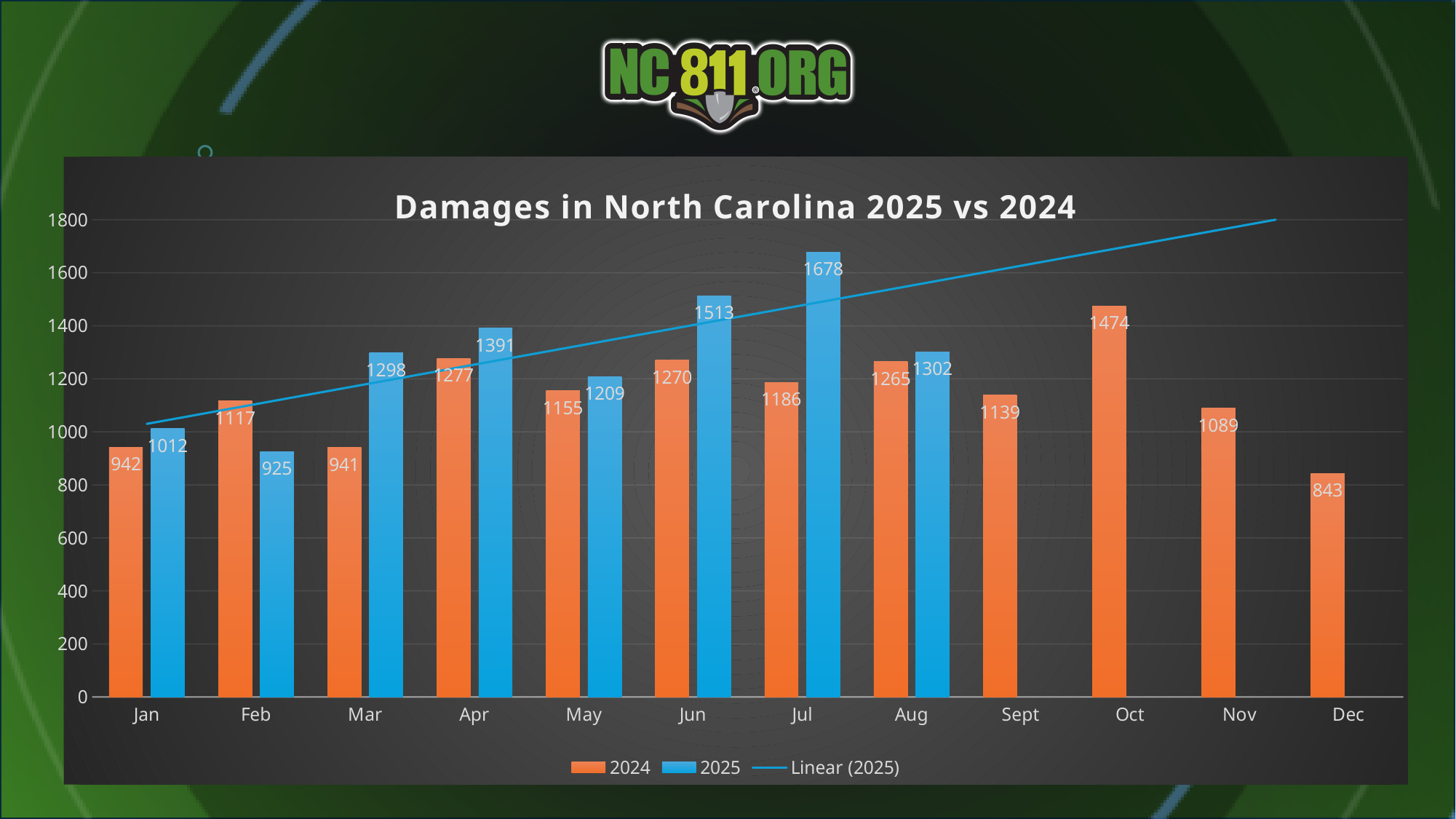
How many entries does the legend list? 3 Which month has the highest 2025 value? Jul What is the title of the chart? Damages in North Carolina 2025 vs 2024 What is the 2024 value for October? 1474 What is the difference between the 2025 and 2024 values for July? 492 What is the 2025 value for February? 925 What kind of chart is shown? Bar chart How many months have a 2025 bar? 8 Which month has the highest 2024 value? Oct Which month has the lowest 2024 value? Dec Which is larger, the 2024 value for February or the 2025 value for February? 2024 What is the 2025 value for July? 1678